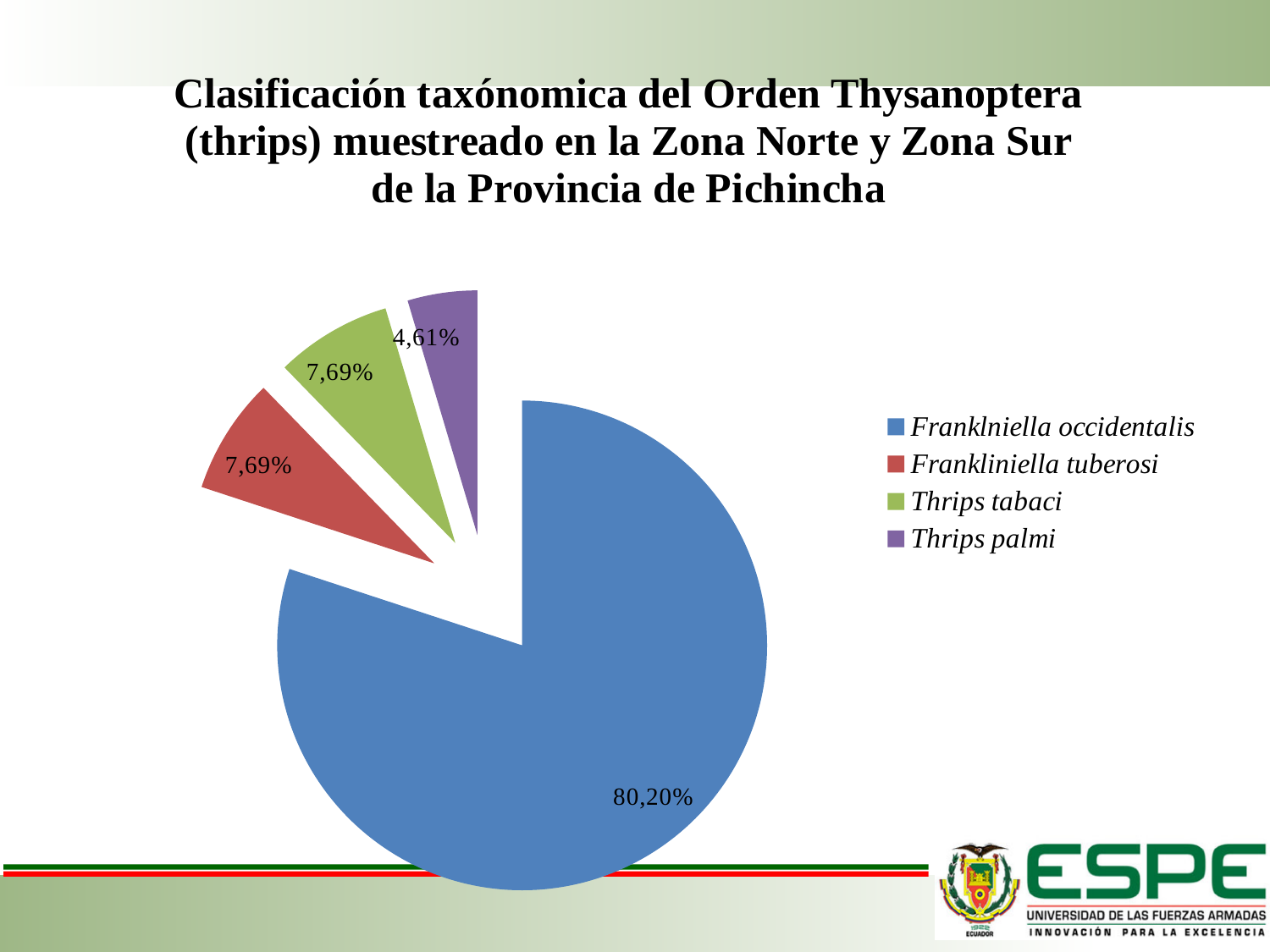
What type of chart is shown on the slide? pie chart How many slices does the pie chart have? 4 What percentage is shown for Thrips palmi? 4,61% What percentage is shown for Frankliniella tuberosi? 7,69% Which species has the smallest share of the pie? Thrips palmi Which has a larger share, Thrips tabaci or Thrips palmi? Thrips tabaci What is the difference in percentage points between Franklniella occidentalis and Thrips palmi? 75,59 What percentage is shown for Thrips tabaci? 7,69% Which species has the largest share of the pie? Franklniella occidentalis Which species is shown in red in the pie chart? Frankliniella tuberosi What percentage of the pie does Franklniella occidentalis represent? 80,20% Which colour represents Thrips palmi in the pie chart? purple